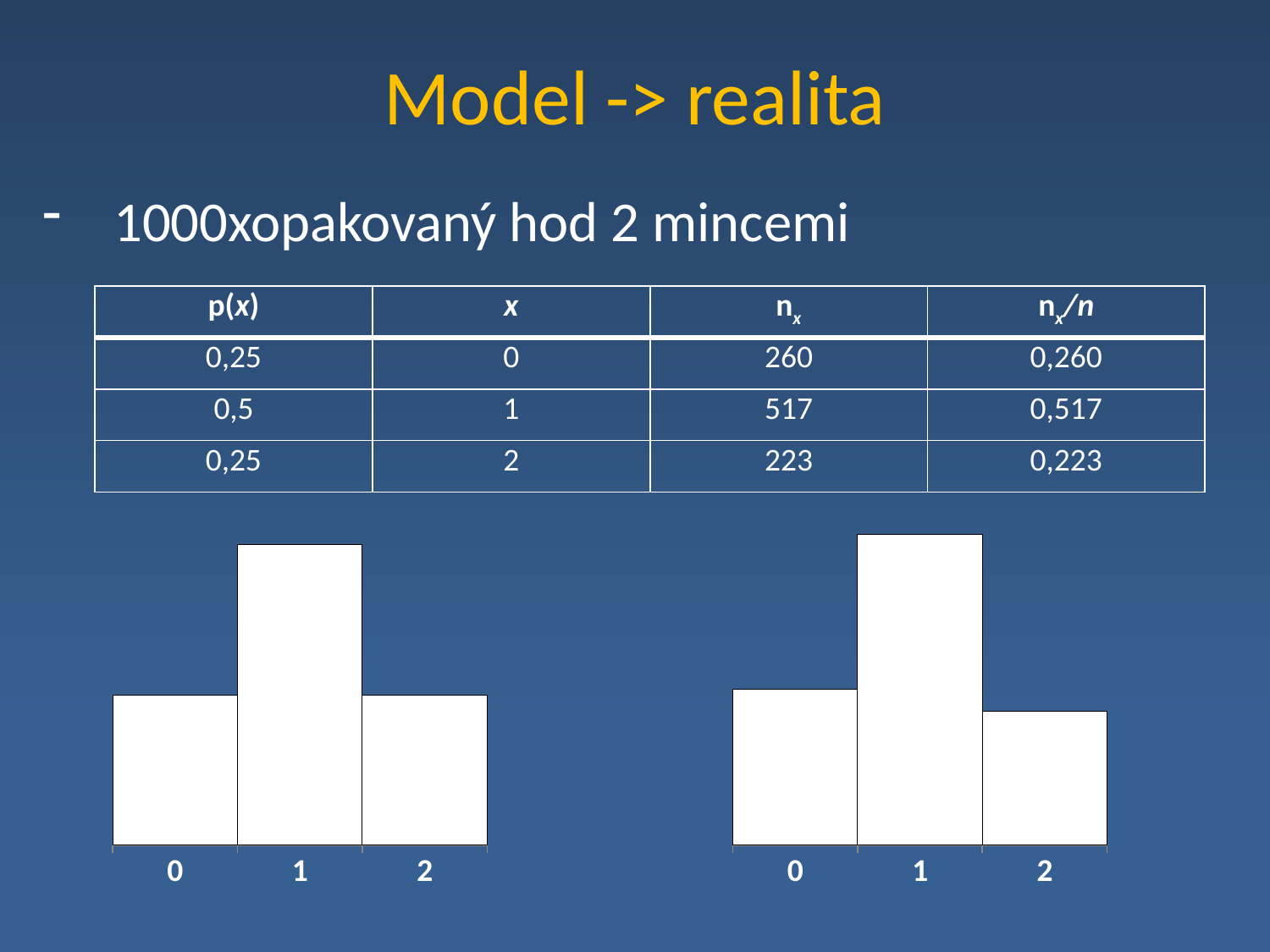
In the right chart, which bar is taller, the one for 0 or the one for 2? 0 In the right chart, which bar is taller, the one for 0 or the one for 1? 1 In the left chart, how many bars are plotted? 3 In the right chart, which category has the highest bar? 1 What kind of chart is the chart on the left of the slide? bar chart In the left chart, which category has the highest bar? 1 What are the category labels on the x axis of the left chart? 0, 1, 2 What kind of chart is the chart on the right of the slide? bar chart In the right chart, which category has the lowest bar? 2 What colour are the bars in the two charts? white In the right chart, how many categories are shown on the x axis? 3 In the left chart, which bar is taller, the one for 1 or the one for 2? 1